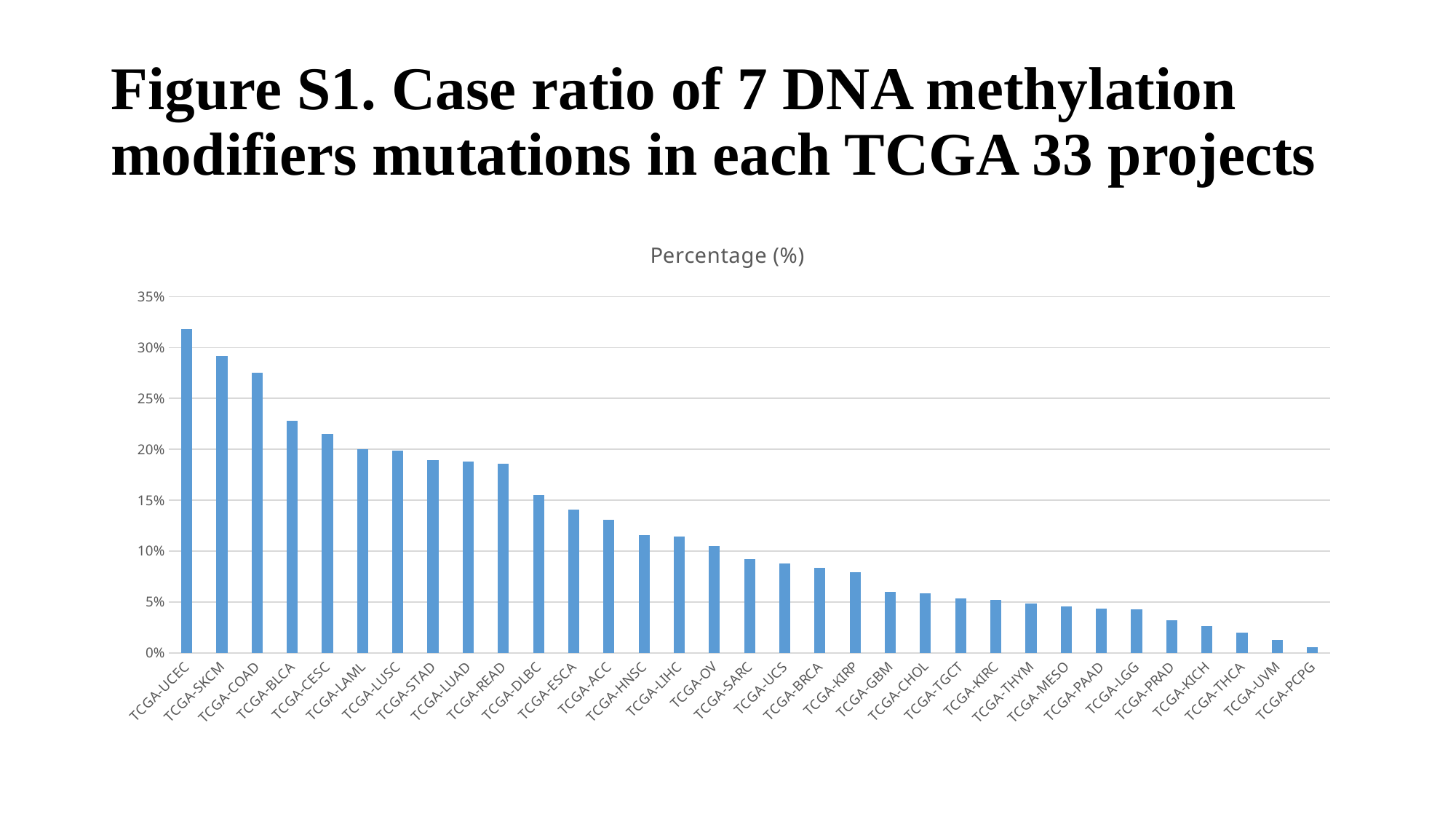
Which has a higher percentage, TCGA-SKCM or TCGA-BLCA? TCGA-SKCM Is the value for TCGA-COAD greater or less than 25%? greater Which TCGA project has the lowest percentage? TCGA-PCPG Is the value for TCGA-SARC greater or less than 10%? less Do the values rise or fall moving from left to right along the x axis? fall What kind of chart is shown on the slide? bar chart Is the value for TCGA-ESCA greater or less than 15%? less What is the title of the chart? Percentage (%) How many TCGA projects (categories) are plotted on the x axis? 33 Which TCGA project has the highest percentage? TCGA-UCEC